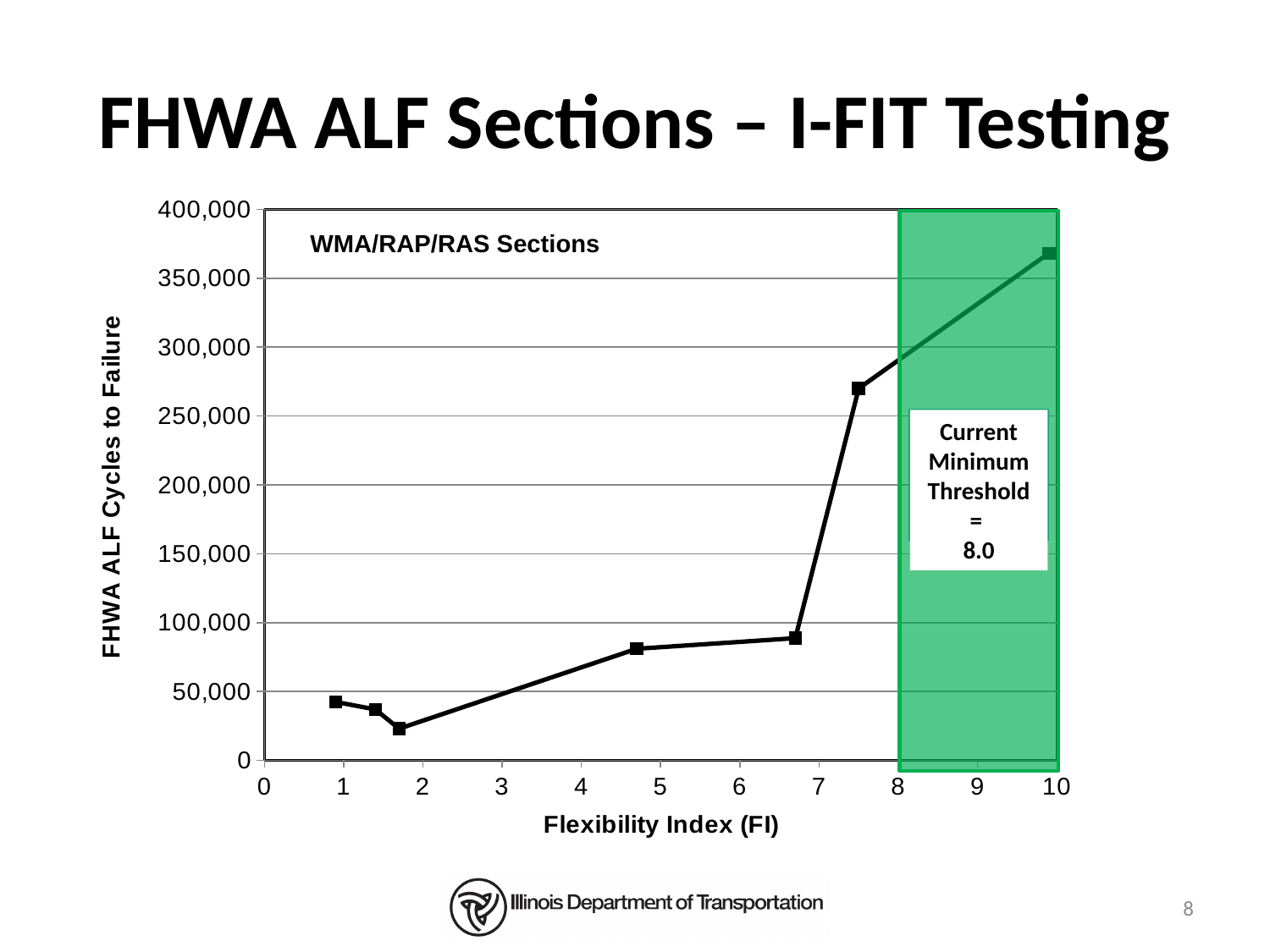
What is the highest value shown on the y axis? 400,000 What is the label of the x axis? Flexibility Index (FI) Which has more cycles to failure: the data point near FI 6.7 or the data point near FI 7.5? the data point near FI 7.5 How many data points are plotted on the line? 7 Which data point has the highest number of cycles to failure: the one near FI 7.5 or the one near FI 10? the one near FI 10 Overall, do the cycles to failure rise or fall as the Flexibility Index increases from about 2 to 10? rise What is the label of the y axis? FHWA ALF Cycles to Failure Is the value of the data point near FI 7.5 greater or less than 250,000? greater What kind of chart is shown on the slide? line chart Is the value of the rightmost data point (near FI 10) greater or less than 350,000? greater Is the value of the lowest data point (near FI 1.7) greater or less than 50,000? less